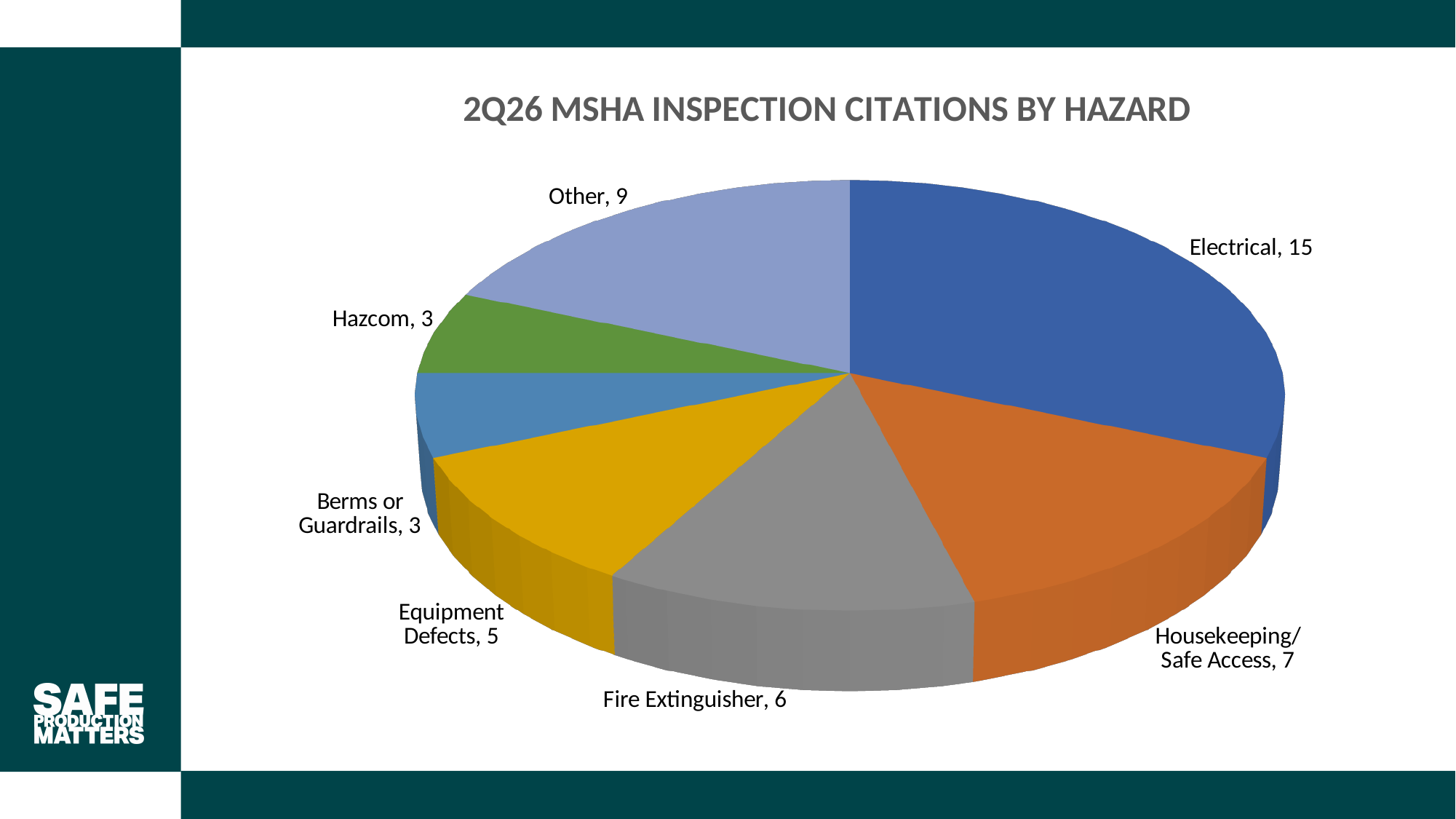
How many hazard categories are shown in the pie chart? 7 What is the title of the chart? 2Q26 MSHA INSPECTION CITATIONS BY HAZARD What is the value for Electrical? 15 What is the difference between the Electrical and Other values? 6 What is the total number of citations across all categories? 48 What kind of chart is shown on the slide? Pie chart What is the value for Housekeeping/Safe Access? 7 How many citations are shown for Fire Extinguisher? 6 Which is larger, Other or Housekeeping/Safe Access? Other What is the difference between Housekeeping/Safe Access and Equipment Defects? 2 What is the value for Equipment Defects? 5 Which hazard category has the highest number of citations? Electrical